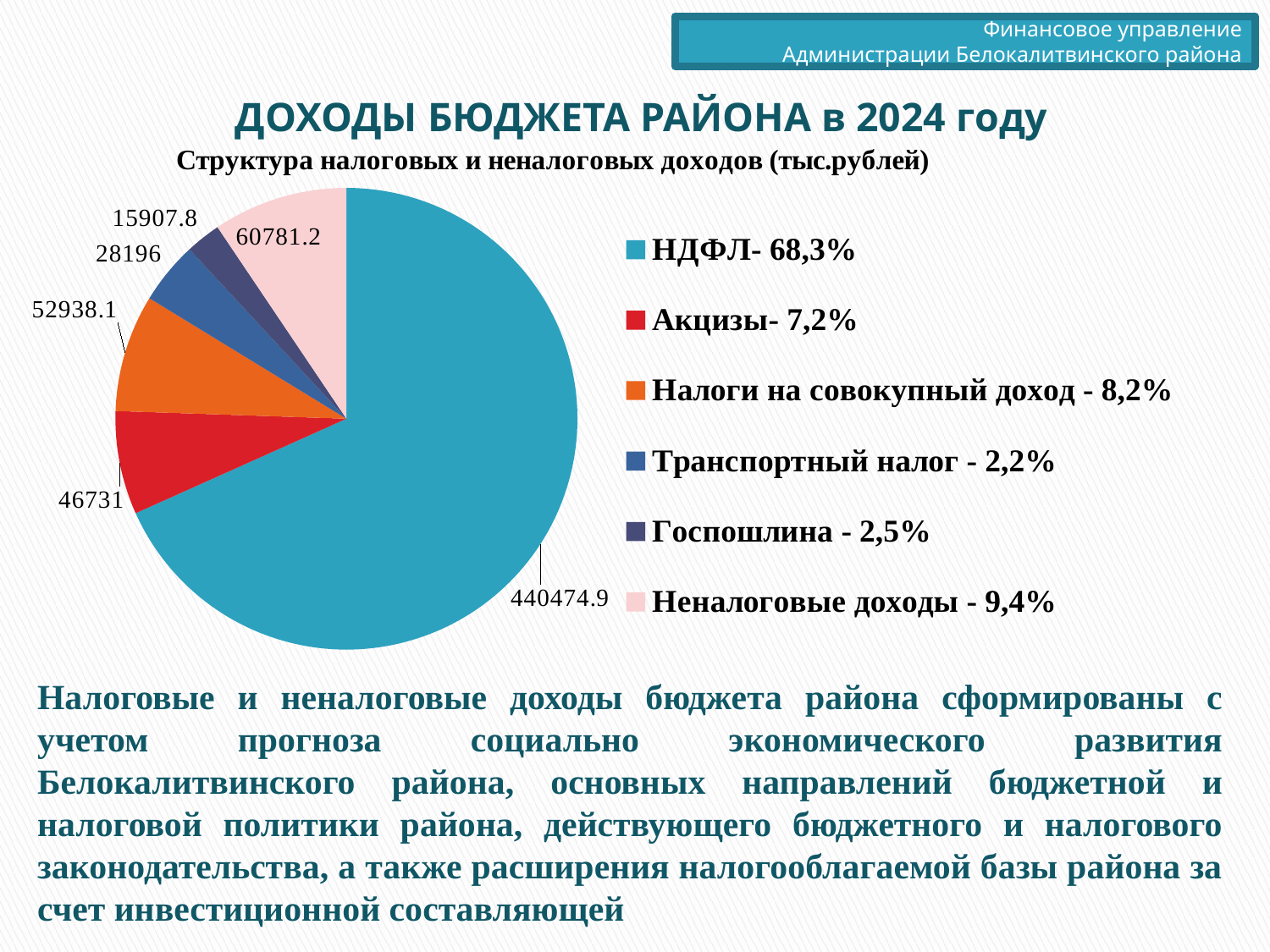
What share of the pie does НДФЛ represent according to the legend? 68,3% What is the value for НДФЛ on the pie chart? 440474.9 Which category has the largest slice of the pie chart? НДФЛ Which category has the smallest slice of the pie chart? Госпошлина Which is larger, the value for Транспортный налог or the value for Госпошлина? Транспортный налог What is the title of the chart? Структура налоговых и неналоговых доходов (тыс.рублей) What is the value for Неналоговые доходы on the pie chart? 60781.2 What is the difference between the values for Налоги на совокупный доход and Акцизы? 6207.1 What type of chart is shown on the slide? pie chart How many slices does the pie chart have? 6 What is the value for Акцизы on the pie chart? 46731 What is the value for Госпошлина on the pie chart? 15907.8